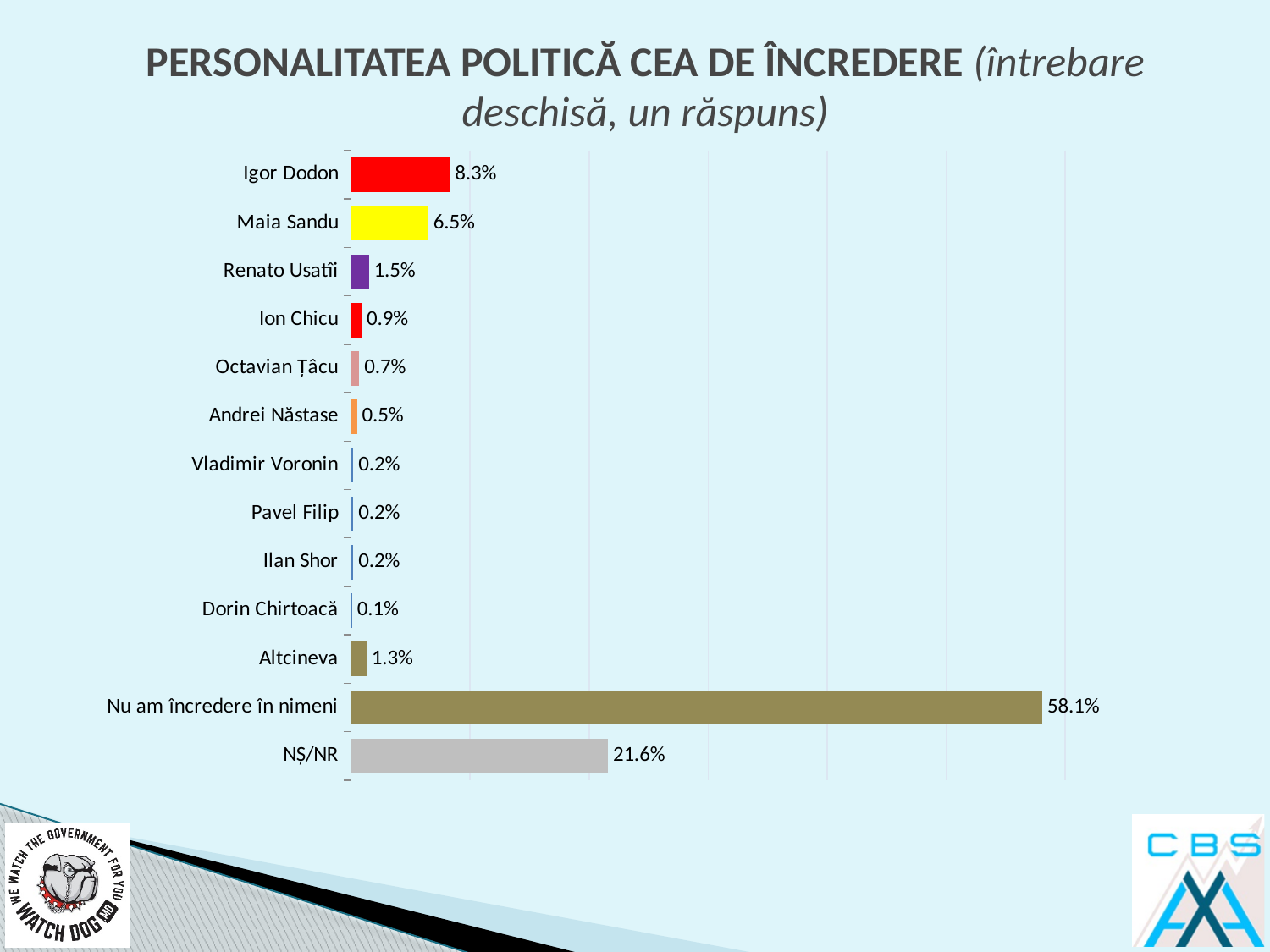
What is the value for Maia Sandu? 6.5% What is the value for Nu am încredere în nimeni? 58.1% Which category has the highest value? Nu am încredere în nimeni What kind of chart is shown on the slide? Bar chart Which category has the lowest value? Dorin Chirtoacă What is the value for Igor Dodon? 8.3% What is the value for NȘ/NR? 21.6% What is the value for Renato Usatîi? 1.5% What is the difference between the values for Igor Dodon and Maia Sandu? 1.8% What is the difference between the values for Nu am încredere în nimeni and NȘ/NR? 36.5% Which is larger, the value for Ion Chicu or the value for Octavian Țâcu? Ion Chicu How many categories are shown in the chart? 13